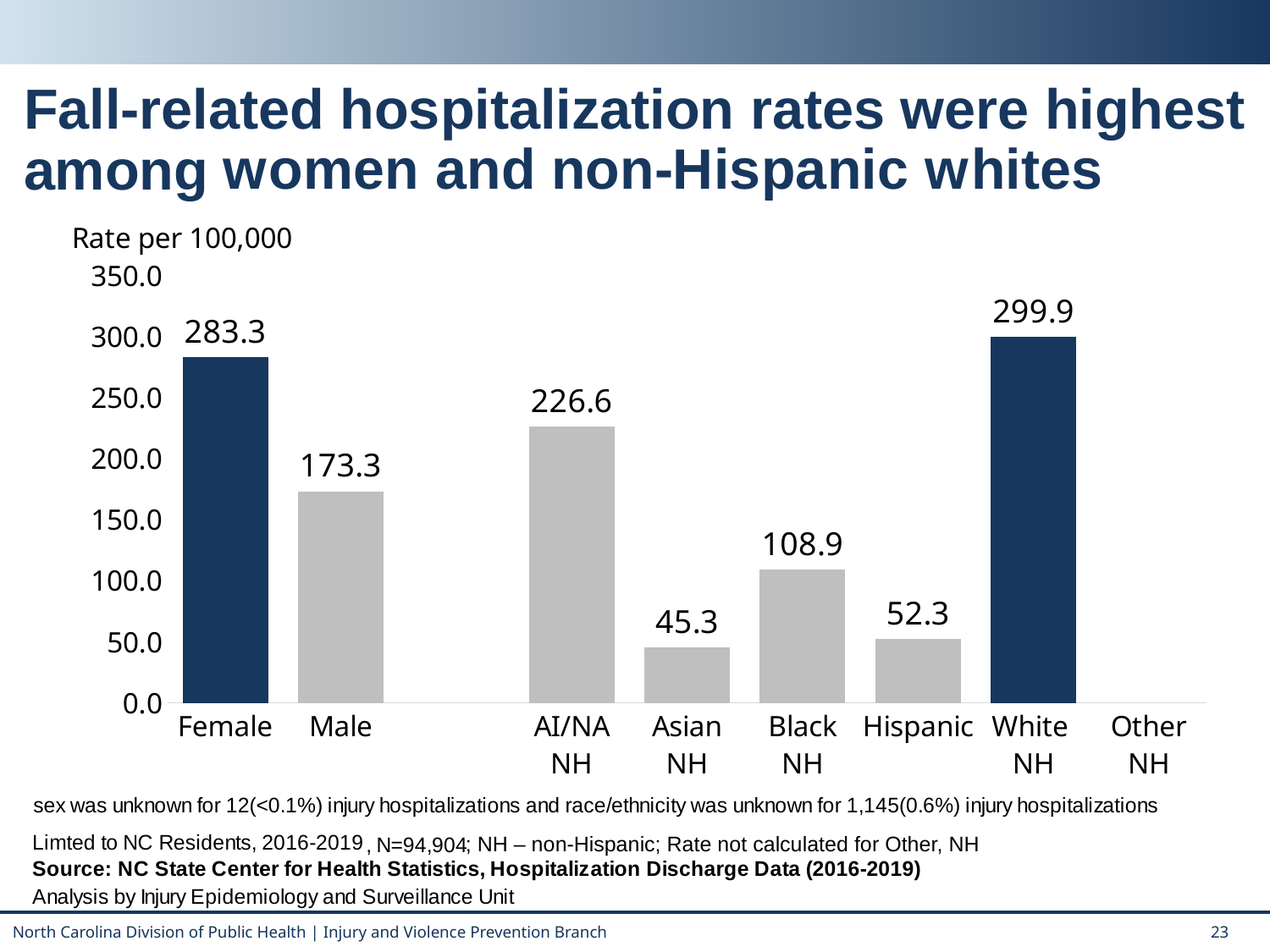
What is the fall-related hospitalization rate per 100,000 for Male? 173.3 Among the race/ethnicity categories with a plotted value, which has the lowest rate? Asian NH What is the difference between the White NH and AI/NA NH rates? 73.3 What kind of chart is shown on the slide? Bar chart What is the rate per 100,000 for Asian NH? 45.3 What is the label on the vertical axis of the chart? Rate per 100,000 Which category has the highest fall-related hospitalization rate? White NH Is the rate for AI/NA NH greater or less than 200.0? greater What is the difference between the Female and Male rates? 110.0 What is the fall-related hospitalization rate per 100,000 for Female? 283.3 Which is larger, the rate for Hispanic or the rate for Black NH? Black NH What is the rate per 100,000 for Black NH? 108.9